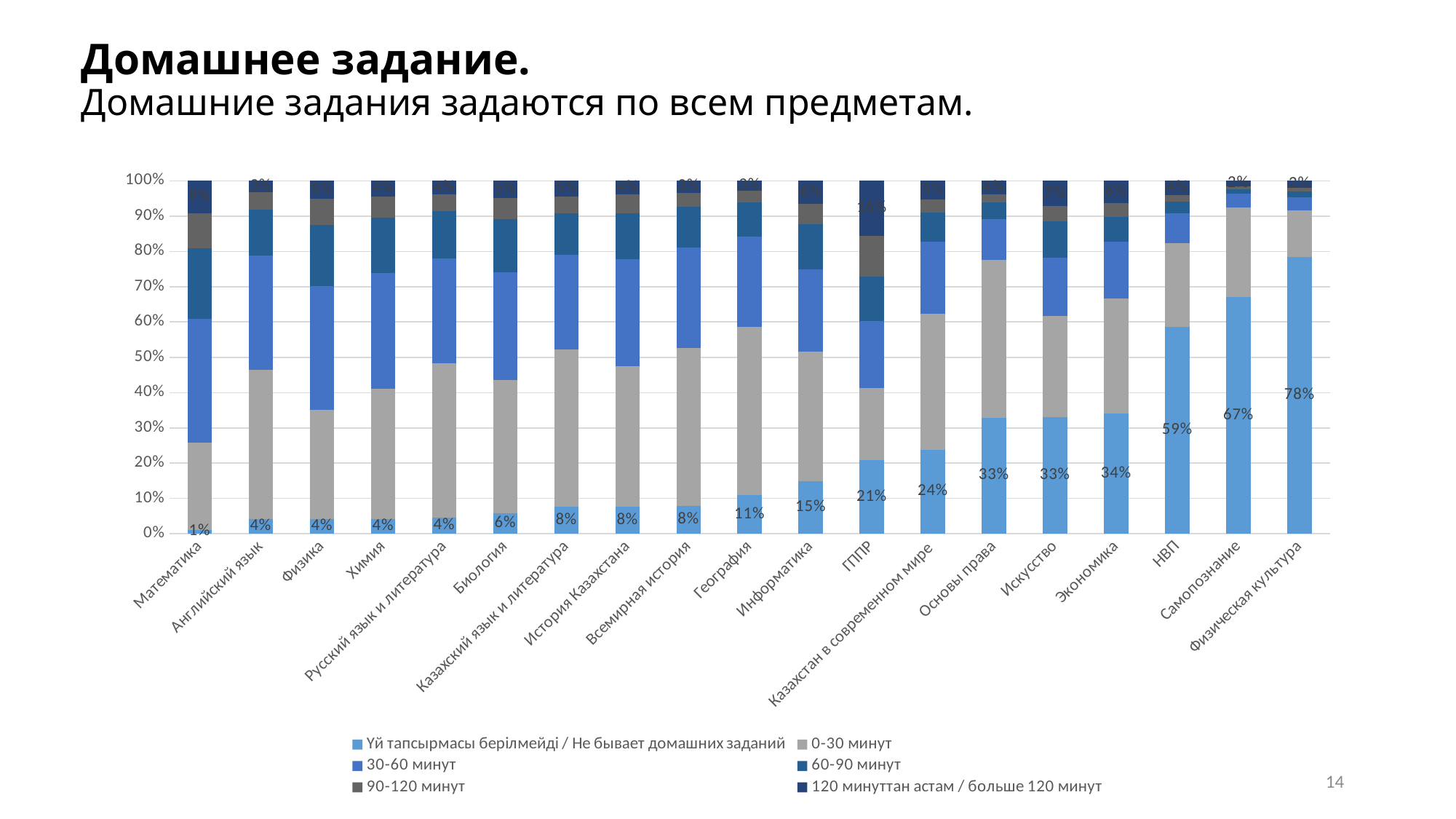
What is the value of 'Не бывает домашних заданий' for Физическая культура? 78% How many series does the chart legend list? 6 Which subject has the highest share of 'Не бывает домашних заданий'? Физическая культура Which has a larger 'Не бывает домашних заданий' value: Самопознание or НВП? Самопознание What is the difference between the 'Не бывает домашних заданий' values for Физическая культура and Математика? 77 percentage points Do the 'Не бывает домашних заданий' values rise or fall moving left to right along the x axis? rise What is the value of 'Не бывает домашних заданий' for НВП? 59% How many subjects (categories) are shown on the x axis of the chart? 19 What type of chart is shown on the slide? stacked bar chart What is the value of 'Не бывает домашних заданий' for Информатика? 15% Which subject has the lowest share of 'Не бывает домашних заданий'? Математика What is the value of 'Үй тапсырмасы берілмейді / Не бывает домашних заданий' for Математика? 1%